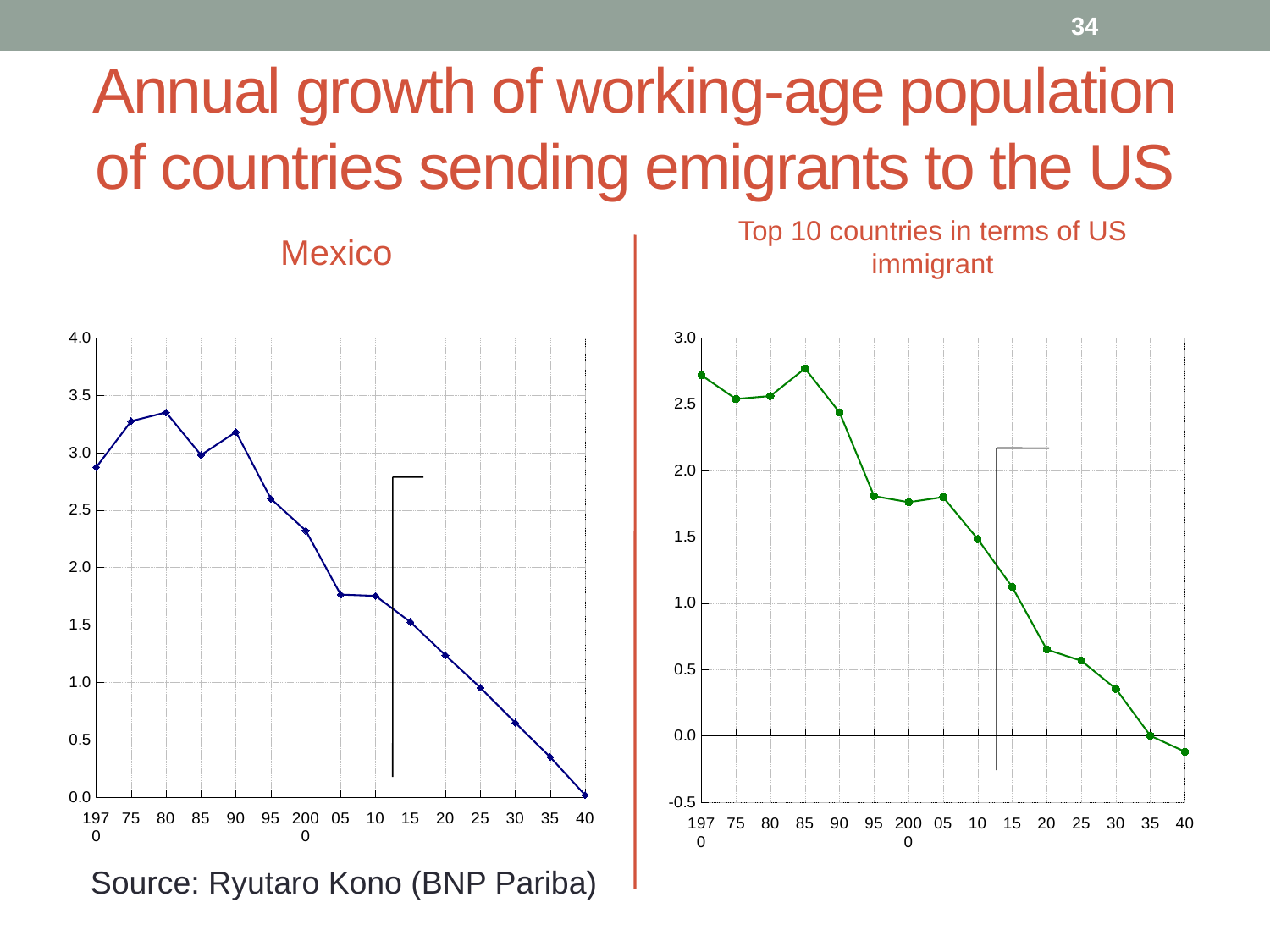
In the 'Top 10 countries in terms of US immigrant' chart, which year has the lowest value? 2040 What source is cited for the charts on the slide? Ryutaro Kono (BNP Pariba) In the Mexico chart, how many data points are plotted? 15 In the Mexico chart, which year has the lowest value? 2040 In the Mexico chart, which year has the highest value? 1980 In the Mexico chart, do the values generally rise or fall from 1990 to 2040? fall In the 'Top 10 countries in terms of US immigrant' chart, is the value for 1995 greater or less than 2.0? less In the 'Top 10 countries in terms of US immigrant' chart, which is larger, the value for 2010 or the value for 2015? 2010 In the Mexico chart, is the value for 1970 greater or less than 2.5? greater What kind of chart is the Mexico chart? line chart In the Mexico chart, which is larger, the value for 1985 or the value for 1990? 1990 In the Mexico chart, is the value for 2005 greater or less than 2.0? less